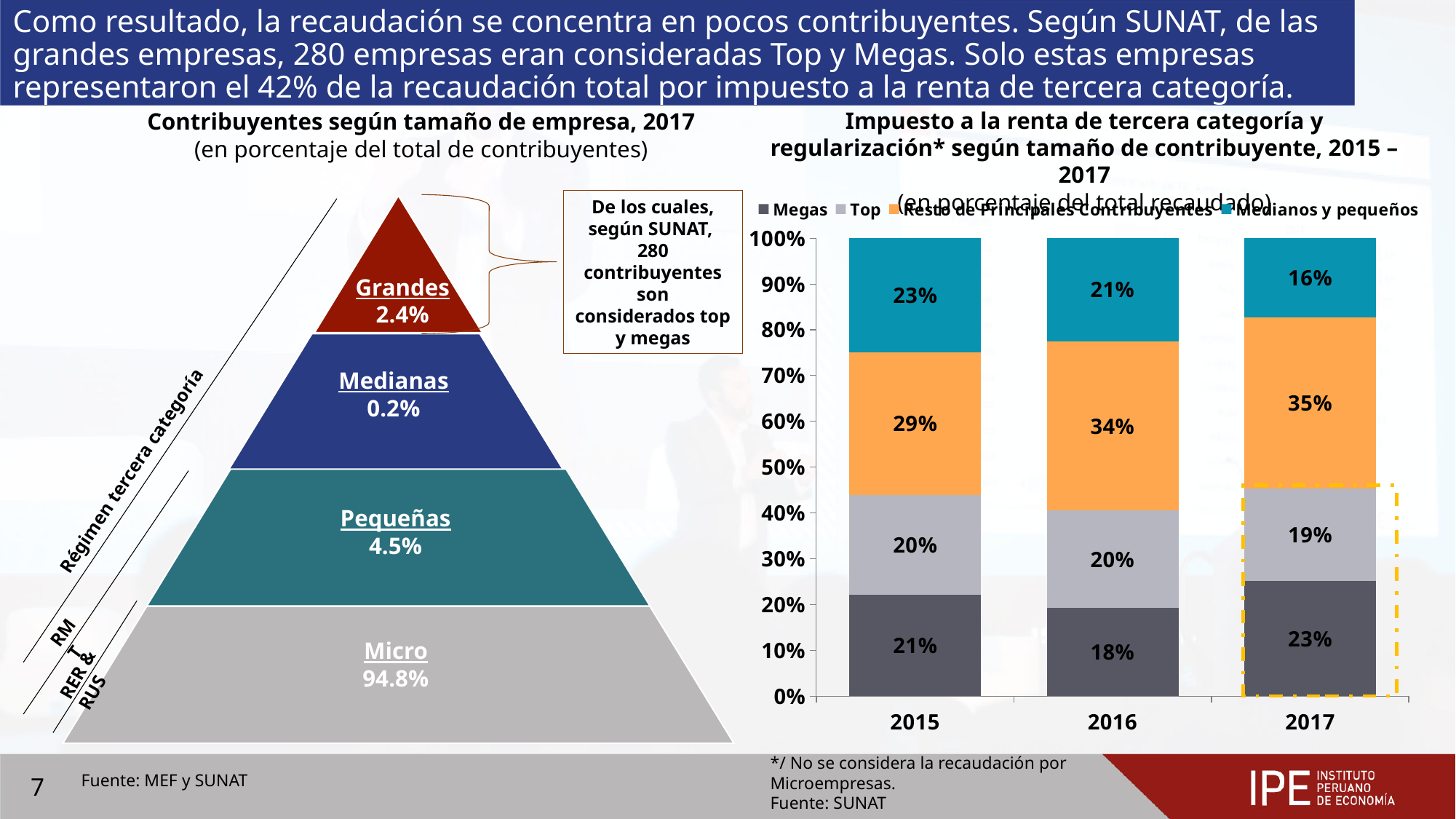
In the stacked bar chart on the right, what is the value for Resto de Principales Contribuyentes in 2016? 34% In the stacked bar chart on the right, by how many percentage points did the Resto de Principales Contribuyentes share change from 2015 to 2017? 6 percentage points In the stacked bar chart on the right, what is the value for Megas in 2017? 23% In the stacked bar chart on the right, in which year is the Megas share lowest? 2016 In the stacked bar chart on the right, is the Top share larger in 2015 or in 2017? 2015 How many series does the legend of the stacked bar chart on the right list? 4 What kind of chart is the chart on the right of the slide? Stacked bar chart In the stacked bar chart on the right, what is the combined share of Megas and Top in 2017? 42% In the pyramid on the left, what percentage of contributors are Micro enterprises? 94.8% In the stacked bar chart on the right, does the Medianos y pequeños share rise or fall from 2015 to 2017? It falls In the stacked bar chart on the right, in which year is the Medianos y pequeños share highest? 2015 How many years are shown on the x axis of the stacked bar chart on the right? 3